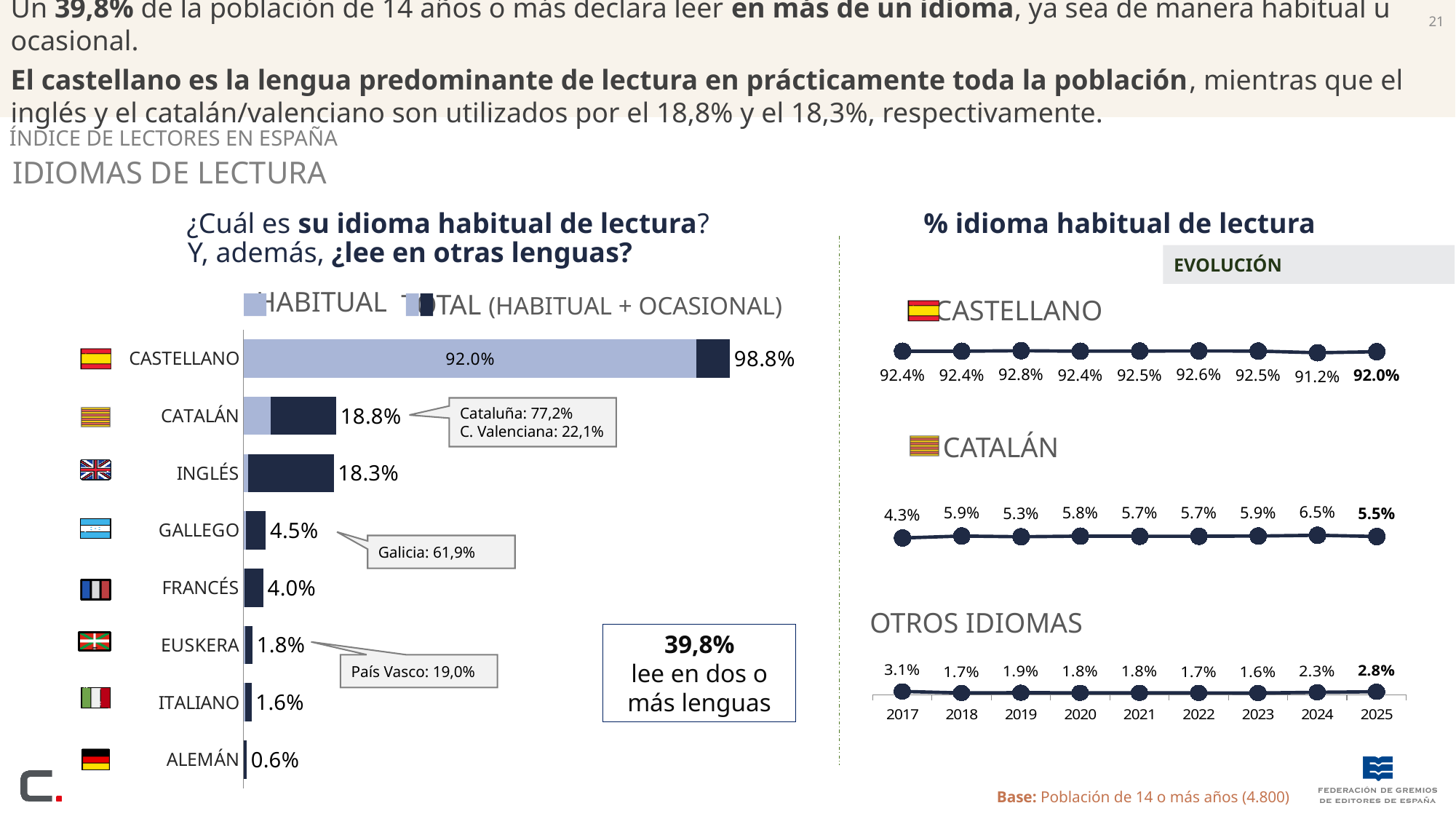
In the bar chart on the left, what is the habitual reading value shown for CASTELLANO? 92.0% In the CASTELLANO evolution line chart on the right, what is the value for 2024? 91.2% In the bar chart on the left, how many languages are listed? 8 In the bar chart on the left, what is the total (habitual + ocasional) value for INGLÉS? 18.3% In the bar chart on the left, what is the difference between the total values for CATALÁN and INGLÉS? 0.5% In the OTROS IDIOMAS evolution line chart on the right, what is the value for 2025? 2.8% In the CATALÁN evolution line chart on the right, which year has the highest value? 2024 In the bar chart on the left, which is larger, the total value for GALLEGO or for FRANCÉS? GALLEGO How many series does the legend of the bar chart on the left list? 2 In the OTROS IDIOMAS evolution line chart on the right, what is the difference between the 2017 and 2018 values? 1.4% What type of chart is used on the left side of the slide to show reading languages? Bar chart In the bar chart on the left, which language has the lowest total value? ALEMÁN